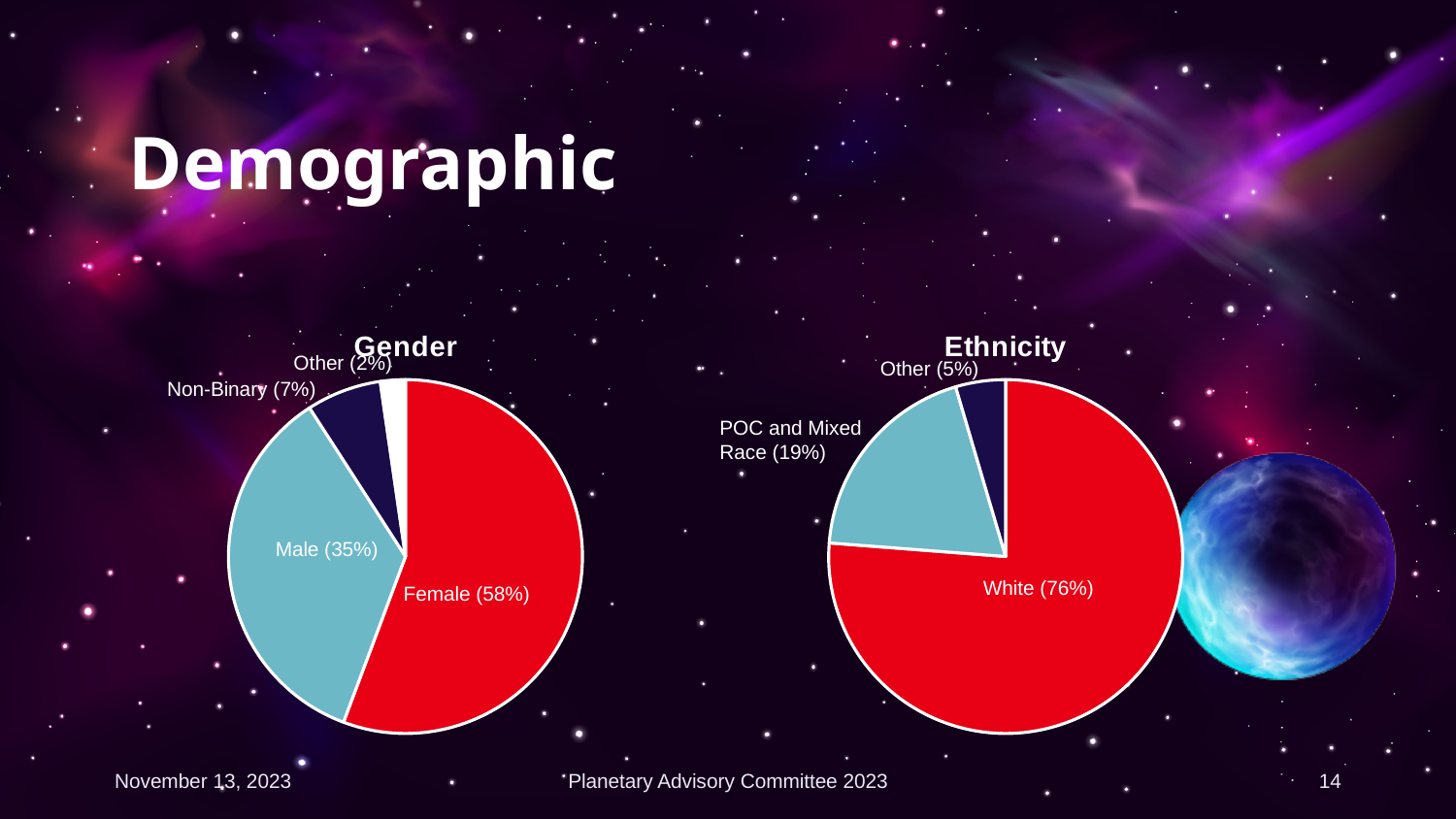
In the Ethnicity chart, what share is POC and Mixed Race? 19% In the Gender chart, which category has the smallest share? Other In the Gender chart, what share is Male? 35% What kind of chart is the Gender chart? Pie chart In the Ethnicity chart, what share is Other? 5% In the Gender chart, what share is Non-Binary? 7% In the Ethnicity chart, which category has the largest share? White How many categories does the Ethnicity chart show? 3 In the Gender chart, which category has the largest share? Female In the Gender chart, what share is Female? 58% In the Ethnicity chart, what share is White? 76% In the Gender chart, what is the difference between the Female and Male shares? 23%